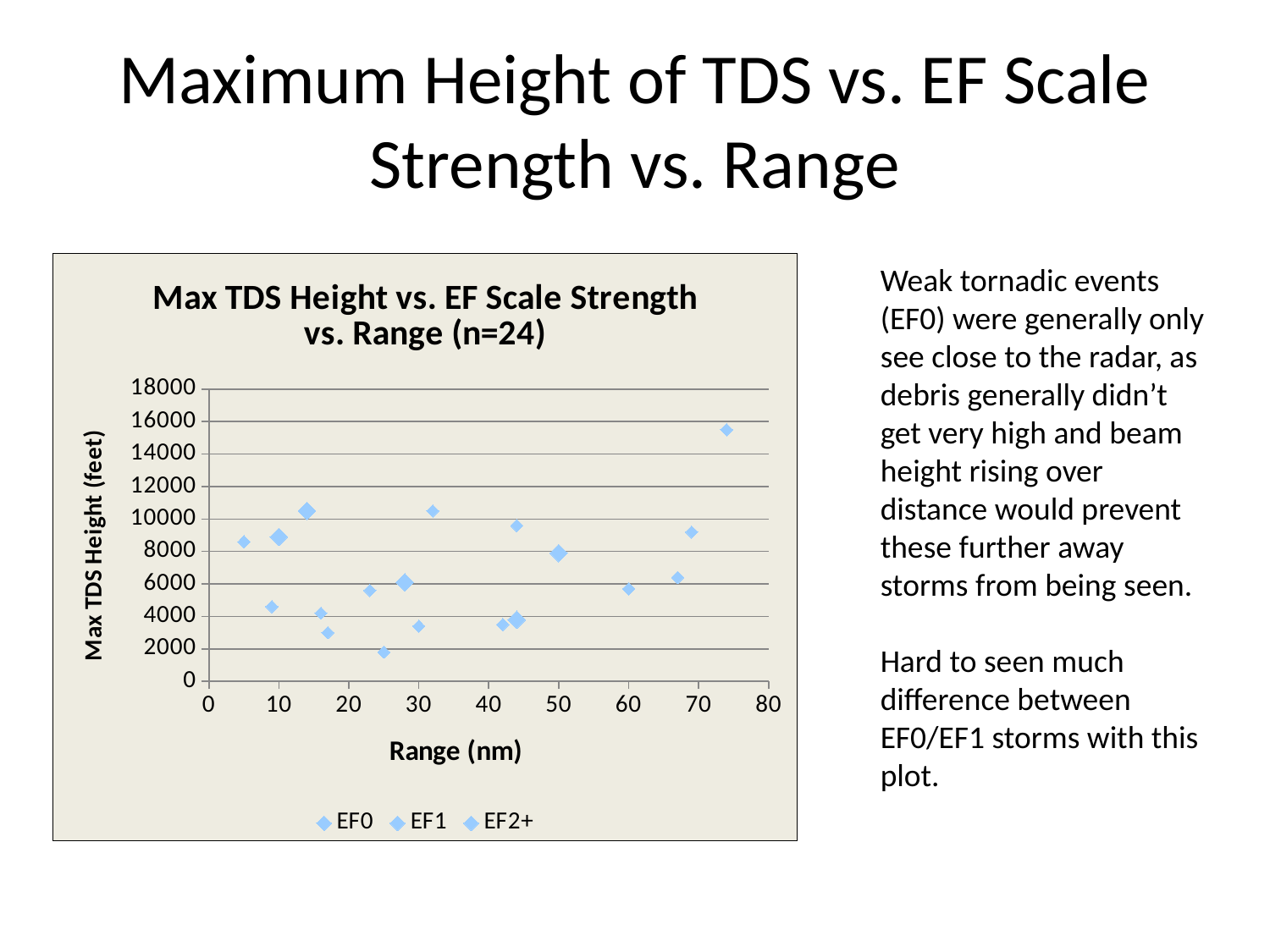
Is the Max TDS Height of the point plotted at about 17 nm range (the lower one) greater or less than 4000 feet? less Is the highest point on the chart located at a range greater or less than 70 nm? greater Is the Max TDS Height of the highest point on the chart greater or less than 14000 feet? greater What kind of chart is shown on the slide? Scatter chart How many series does the chart legend list? 3 How many data points does the chart title say are included (n)? 24 What is the title of the chart? Max TDS Height vs. EF Scale Strength vs. Range (n=24) What are the series names listed in the chart legend? EF0, EF1, EF2+ What is the maximum value shown on the x axis (Range) of the chart? 80